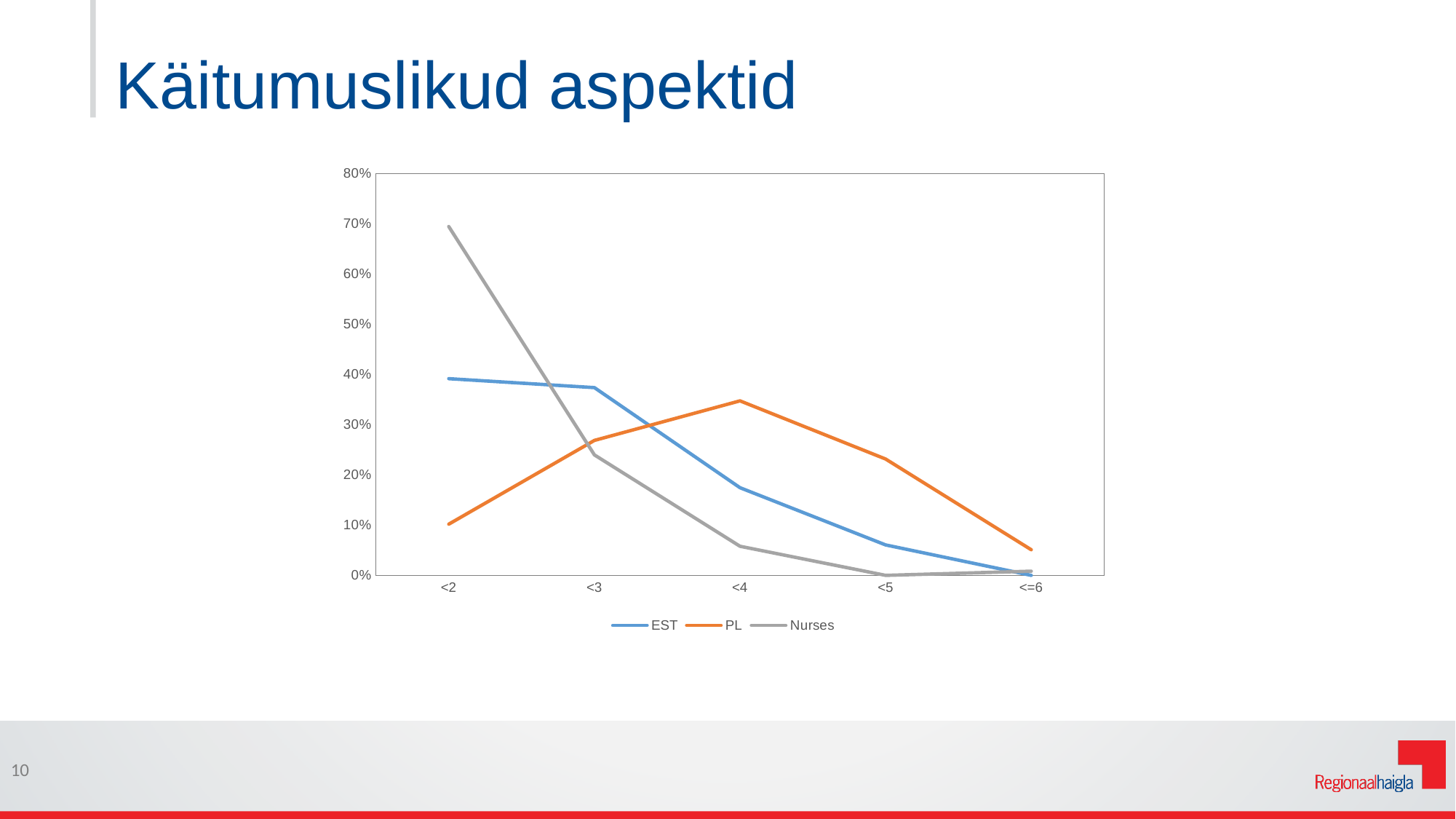
At which category does the PL series reach its highest value? <4 Do the values for EST rise or fall from <2 to <=6? fall What are the three legend entries of the chart? EST, PL, Nurses Is the value for EST at <4 greater or less than 10%? greater Which series has the highest value at the <4 category? PL How many categories are shown on the x axis? 5 Is the value for Nurses at <2 greater or less than 60%? greater What kind of chart is shown on the slide? line chart How many series does the legend list? 3 At the <3 category, which is larger: EST or Nurses? EST Which series has the highest value at the <2 category? Nurses Is the value for PL at <2 greater or less than 20%? less